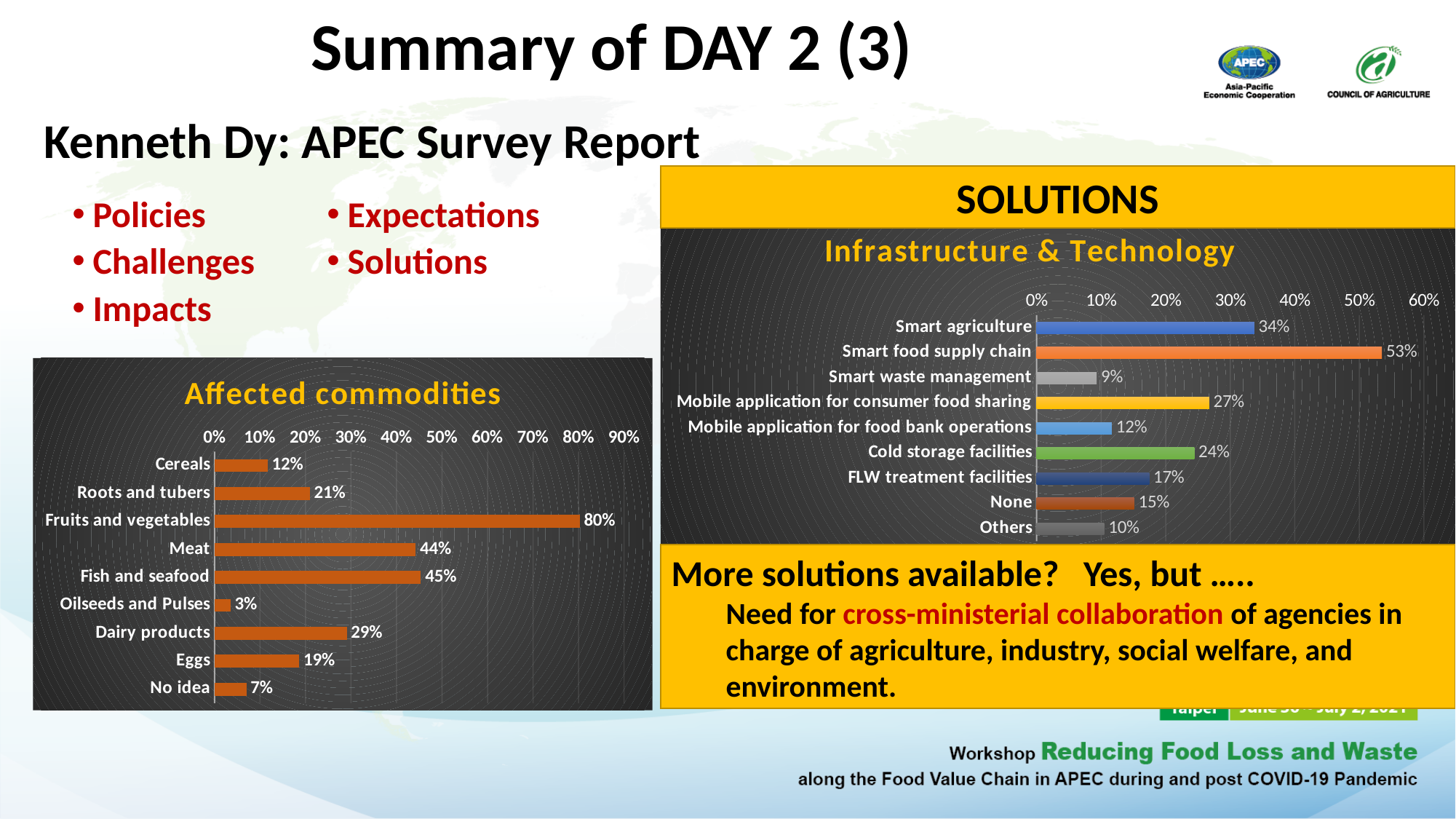
In the 'Affected commodities' chart, what is the value for Fruits and vegetables? 80% In the 'Infrastructure & Technology' chart, what is the value for Smart food supply chain? 53% In the 'Affected commodities' chart, what is the difference between Meat and Cereals? 32% In the 'Affected commodities' chart, which category has the lowest value? Oilseeds and Pulses In the 'Infrastructure & Technology' chart, which category has the highest value? Smart food supply chain In the 'Infrastructure & Technology' chart, what is the difference between Smart agriculture and Cold storage facilities? 10% In the 'Affected commodities' chart, what is the value for Dairy products? 29% In the 'Affected commodities' chart, which is larger, Roots and tubers or Eggs? Roots and tubers In the 'Affected commodities' chart, how many categories are shown? 9 What type of chart is the 'Infrastructure & Technology' chart? Bar chart In the 'Infrastructure & Technology' chart, how many categories are shown? 9 In the 'Infrastructure & Technology' chart, which category has the lowest value? Smart waste management